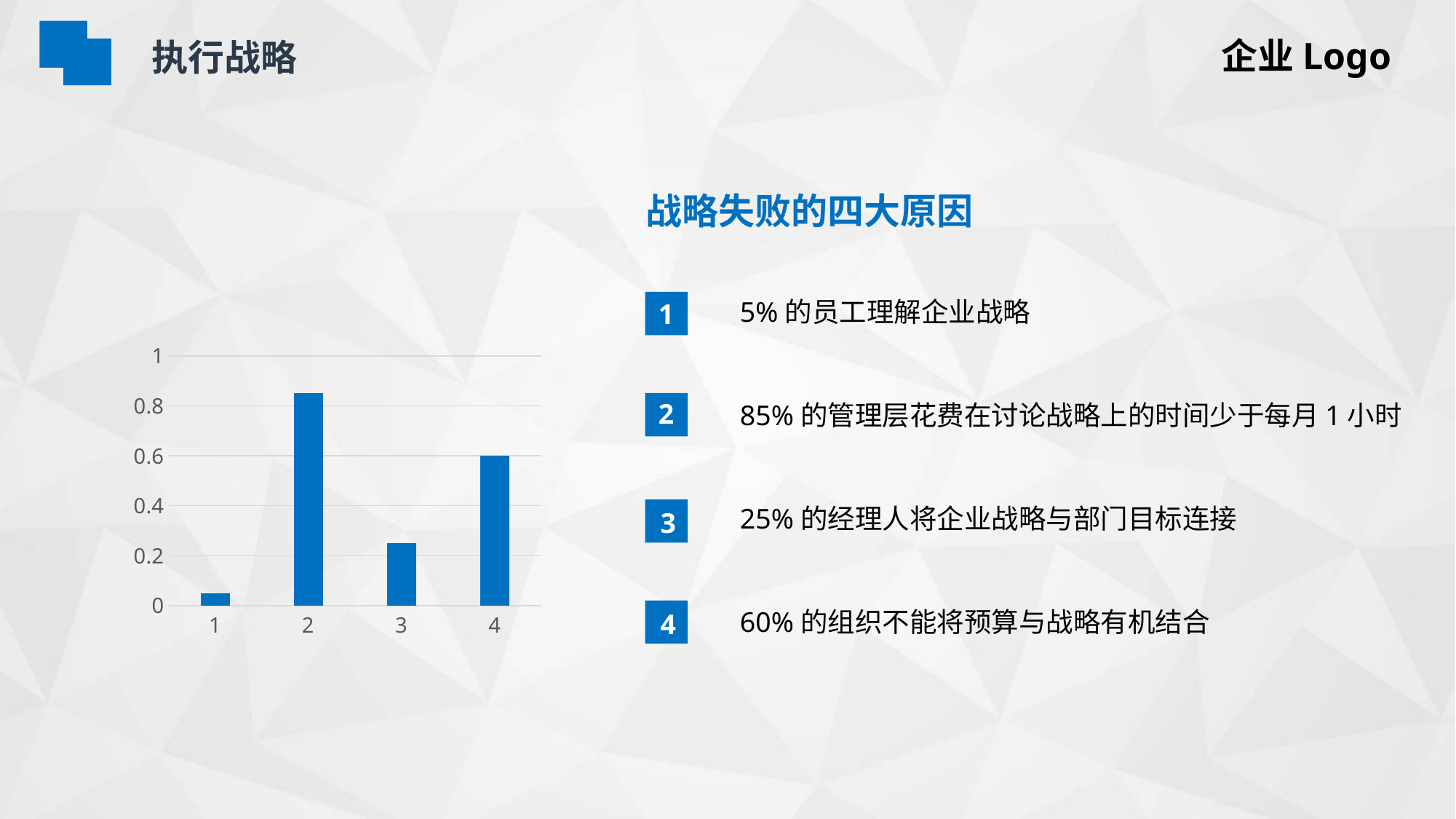
How many categories are plotted on the x axis of the chart? 4 Which category has the lowest bar in the chart? 1 Which is larger, the value for category 3 or the value for category 4? 4 Which category has the highest bar in the chart? 2 What kind of chart is shown on the slide? bar chart Is the value for category 2 greater or less than 0.8? greater Which is larger, the value for category 2 or the value for category 4? 2 What colour are the bars in the chart? blue What is the highest tick value shown on the y axis of the chart? 1 Is the value for category 1 greater or less than 0.2? less Is the value for category 4 greater or less than 0.4? greater